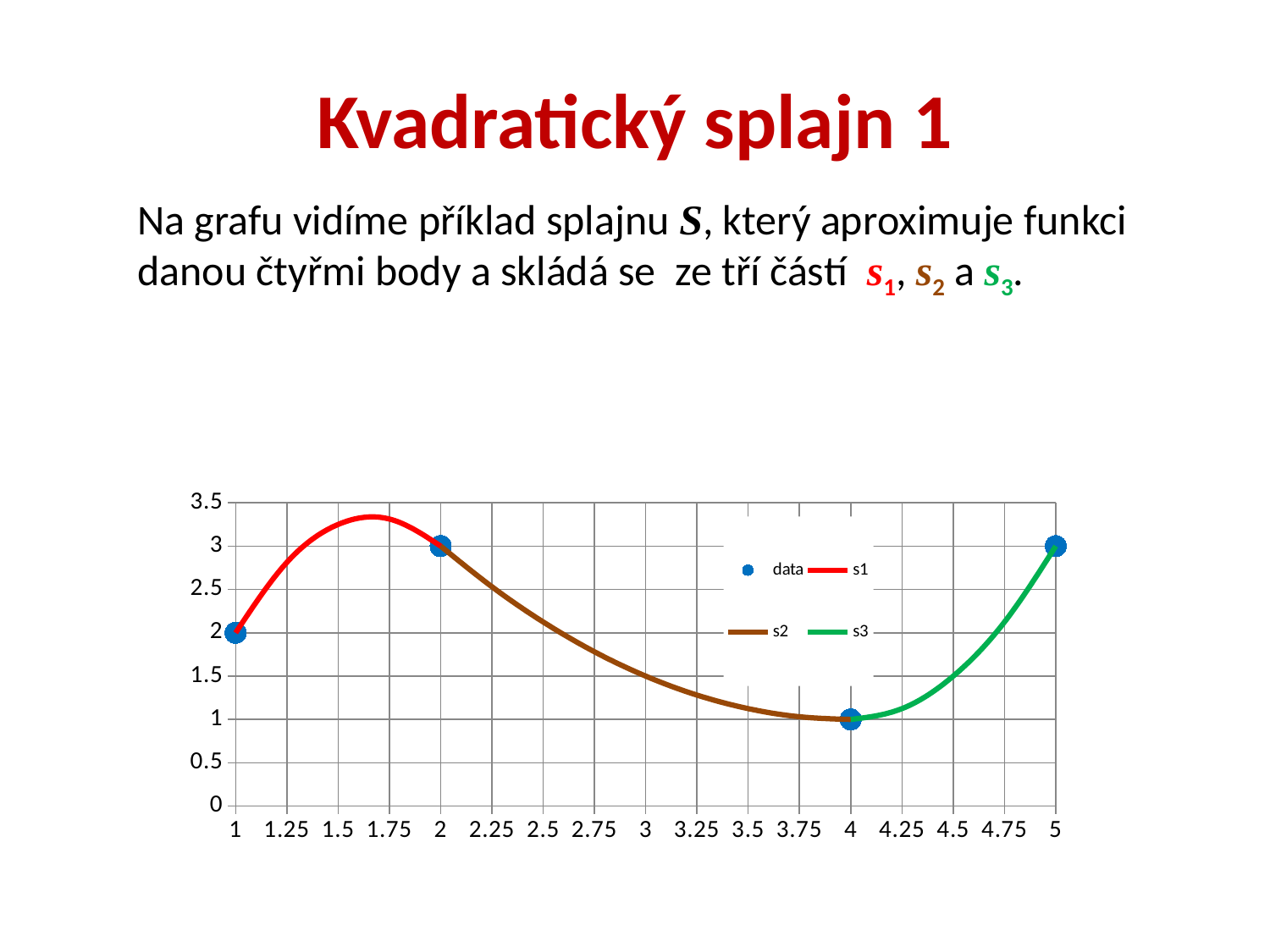
Is the peak of the s1 curve greater or less than 3? greater How many data points are plotted in the 'data' series? 4 What is the y value of the data point at x = 1? 2 What is the difference between the y values of the data points at x = 2 and x = 4? 2 How many series does the legend list? 4 Which data point has the larger y value, the one at x = 1 or the one at x = 4? x = 1 What colour is the s3 curve in the chart? green Does the s2 curve rise or fall as x increases from 2 to 4? fall What is the y value of the data point at x = 4? 1 At which x value does the data series reach its lowest y value? 4 What is the y value of the data point at x = 5? 3 What is the y value of the data point at x = 2? 3